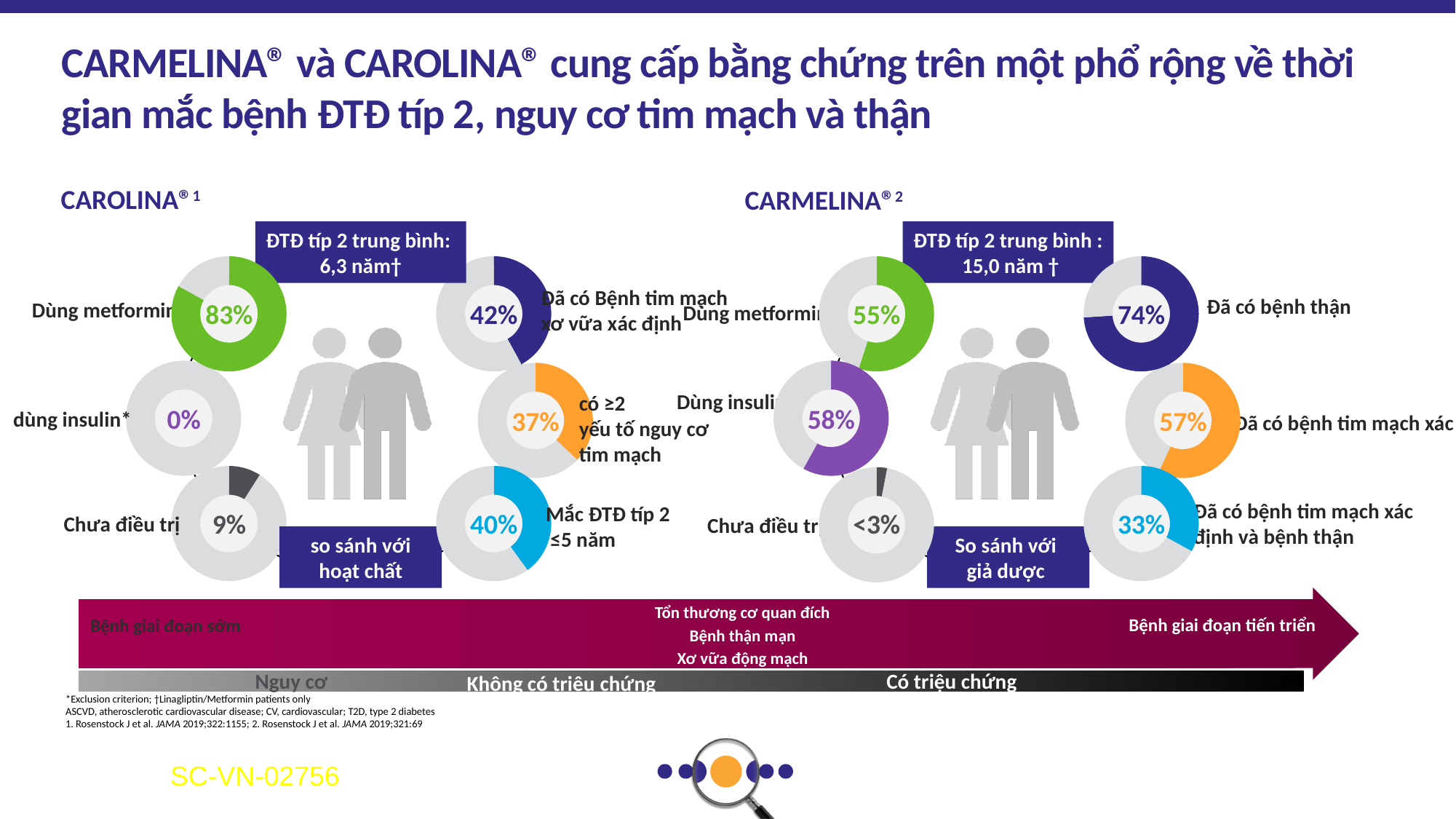
Which is larger: the metformin use percentage in CAROLINA or the metformin use percentage in CARMELINA? CAROLINA (83%) In the CARMELINA panel, what percentage of patients were using insulin (Dùng insulin)? 58% In the CAROLINA panel, what percentage of patients were using metformin (Dùng metformin)? 83% In the CAROLINA panel, what is the difference between the metformin use percentage and the untreated percentage? 74% In the CAROLINA panel, what percentage of patients had established atherosclerotic cardiovascular disease (Đã có Bệnh tim mạch xơ vữa xác định)? 42% In the CAROLINA panel, which of the six donut charts shows the lowest percentage? dùng insulin (0%) What type of chart is used to display the percentages in each panel? Donut (pie) chart In the CARMELINA panel, what percentage of patients already had kidney disease (Đã có bệnh thận)? 74% In the CARMELINA panel, what value is shown for untreated patients (Chưa điều trị)? <3% What is the mean duration of type 2 diabetes shown for the CARMELINA panel? 15,0 năm In the CAROLINA panel, what percentage of patients had type 2 diabetes for ≤5 years (Mắc ĐTĐ típ 2 ≤5 năm)? 40% In the CARMELINA panel, which of the six donut charts shows the highest percentage? Đã có bệnh thận (74%)